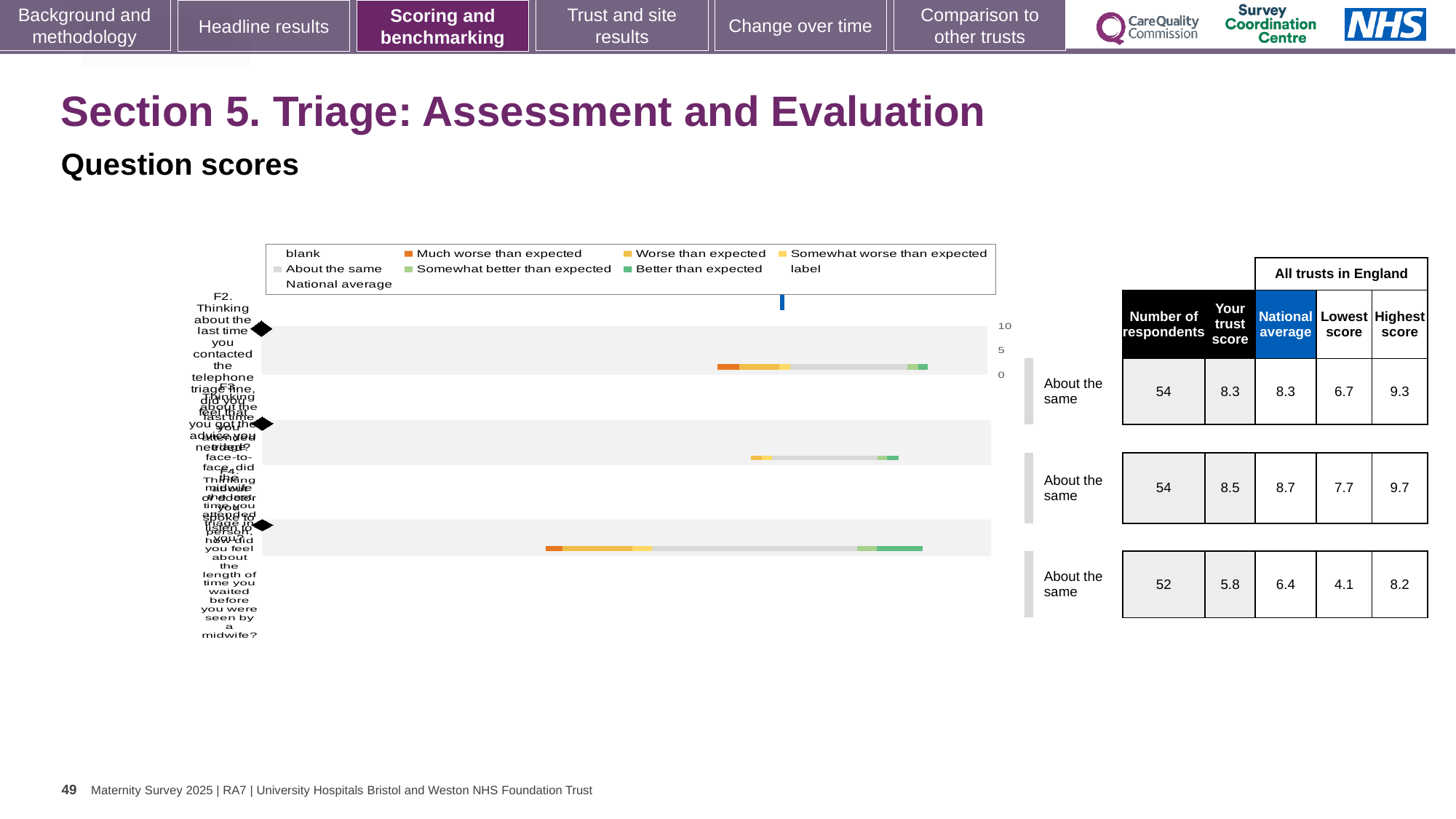
In the table next to the chart, what is the number of respondents for the first row (F2)? 54 Which legend entry is shown in dark green in the chart? Better than expected In the table next to the chart, what is the national average for the second row (F3)? 8.7 In the table next to the chart, what is the difference between the national average and the trust score for the third row (F4)? 0.6 What kind of chart is shown on the slide? bar chart In the table next to the chart, what is the highest score for the third row (F4)? 8.2 How many question rows (bars) are plotted in the chart? 3 How many entries does the chart's legend list? 9 Which legend entry is shown in orange in the chart? Much worse than expected In the table next to the chart, what is the trust score for the third row (F4)? 5.8 In the table next to the chart, which row has the lowest trust score? F4 (5.8) What benchmark category is shown beside each bar in the chart? About the same